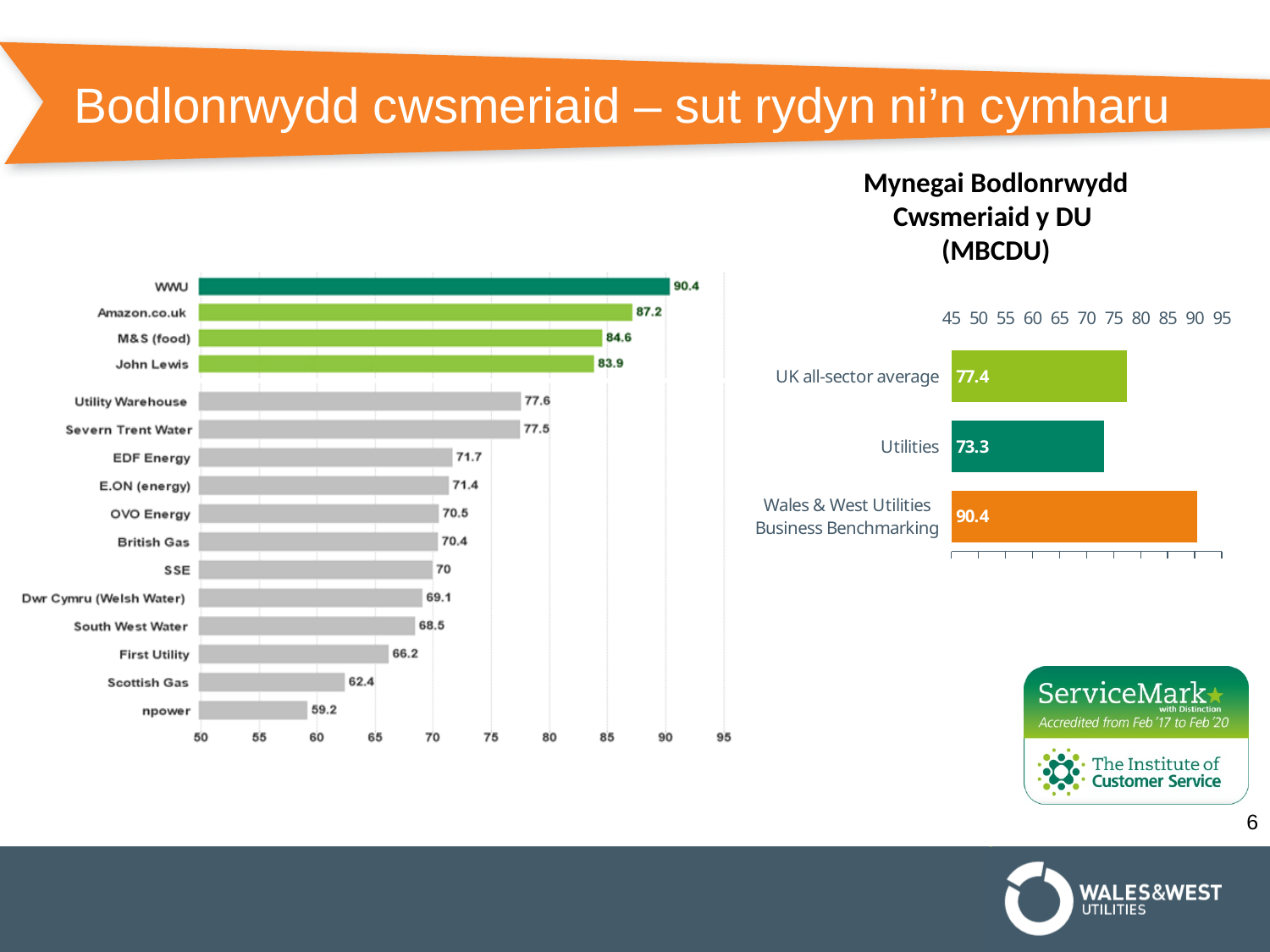
In the chart titled Mynegai Bodlonrwydd Cwsmeriaid y DU (MBCDU), what is the value for Utilities? 73.3 In the left chart, what is the value for WWU? 90.4 In the left chart, which category has the lowest value? npower In the left chart, what is the value for Dwr Cymru (Welsh Water)? 69.1 In the left chart, which is larger, the value for EDF Energy or the value for E.ON (energy)? EDF Energy In the left chart, what is the difference between the values for WWU and Amazon.co.uk? 3.2 In the left chart, which category has the highest value? WWU What kind of chart is the chart titled Mynegai Bodlonrwydd Cwsmeriaid y DU (MBCDU)? Bar chart In the chart titled Mynegai Bodlonrwydd Cwsmeriaid y DU (MBCDU), what is the difference between Wales & West Utilities Business Benchmarking and the UK all-sector average? 13.0 In the left chart, what is the value for npower? 59.2 In the left chart, how many categories are plotted? 16 In the chart titled Mynegai Bodlonrwydd Cwsmeriaid y DU (MBCDU), which category has the lowest value? Utilities